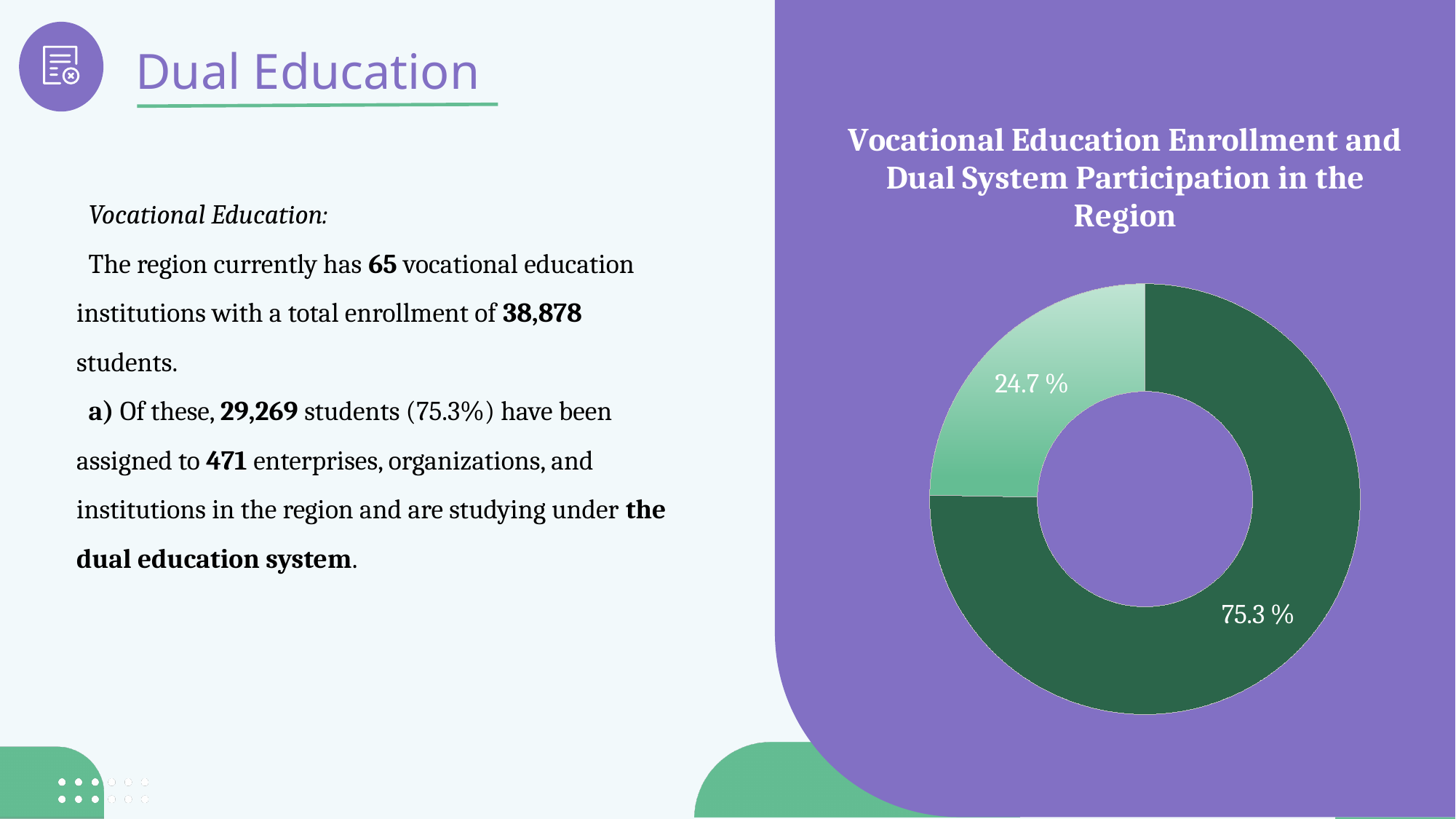
How many slices does the donut chart have? 2 Which slice of the chart is the smallest? The light green slice (24.7 %) What percentage is shown on the larger, dark green slice of the chart? 75.3 % Which slice of the chart is the largest, the dark green one or the light green one? The dark green one What is the difference in percentage points between the two slices of the chart? 50.6 What is the total of the two slice percentages shown on the chart? 100 % Is the dark green slice larger or smaller than the light green slice? Larger What kind of chart is shown on the slide? Pie chart (donut) What percentage is shown on the smaller, light green slice of the chart? 24.7 % Is the value of the light green slice greater or less than 25%? less What share of the chart does the dark green slice represent? 75.3 % What is the title of the chart? Vocational Education Enrollment and Dual System Participation in the Region